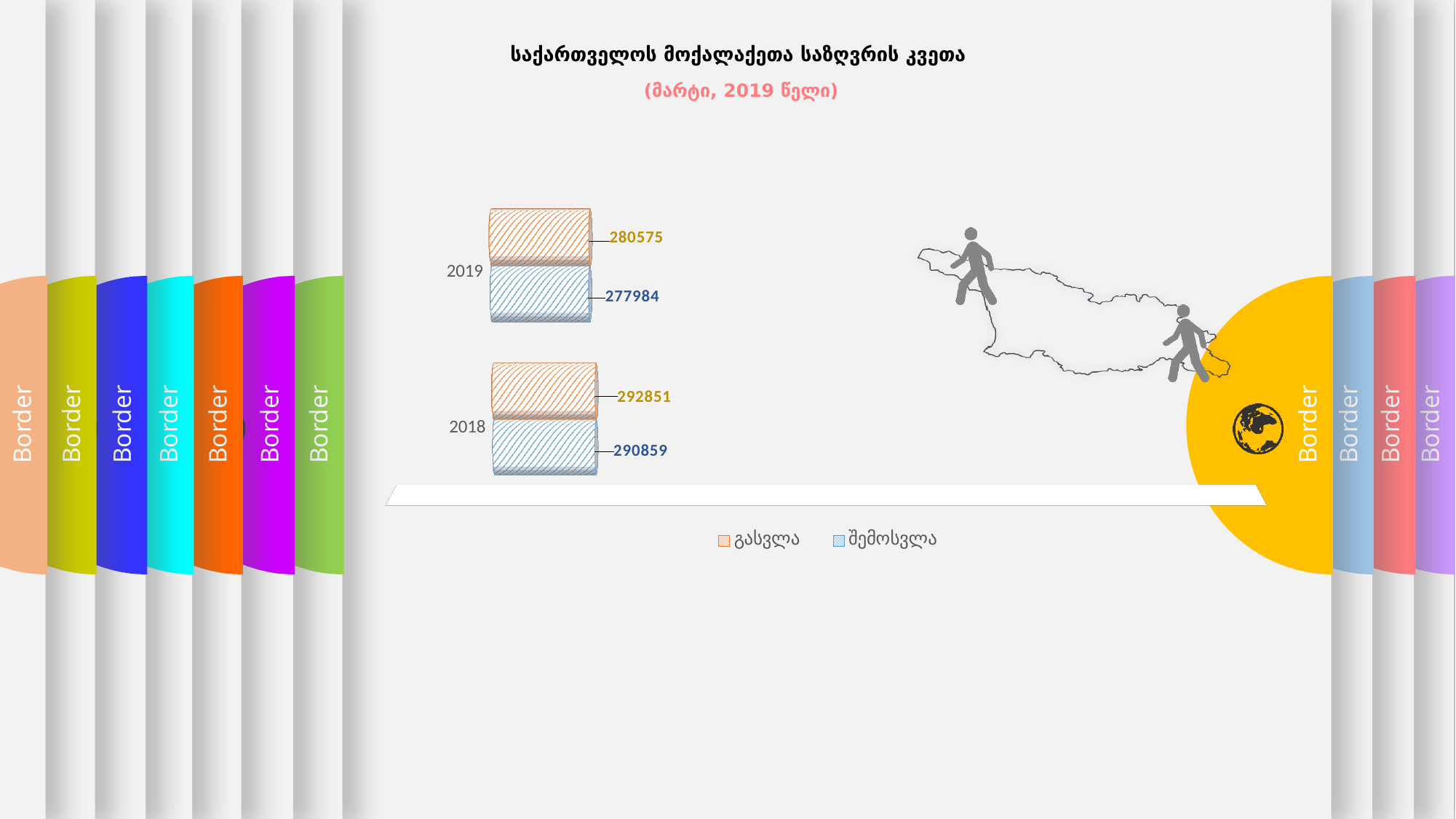
What is the value for გასვლა in 2018? 292851 In 2018, which is larger: გასვლა or შემოსვლა? გასვლა What is the difference between the გასვლა values for 2018 and 2019? 12276 What is the value for შემოსვლა in 2018? 290859 How many series does the legend list? 2 Which year has the lower value for შემოსვლა? 2019 What kind of chart is shown on the slide? bar chart Which year has the higher value for გასვლა? 2018 What is the difference between გასვლა and შემოსვლა in 2019? 2591 What is the value for შემოსვლა in 2019? 277984 What is the value for გასვლა in 2019? 280575 How many years are shown on the chart? 2